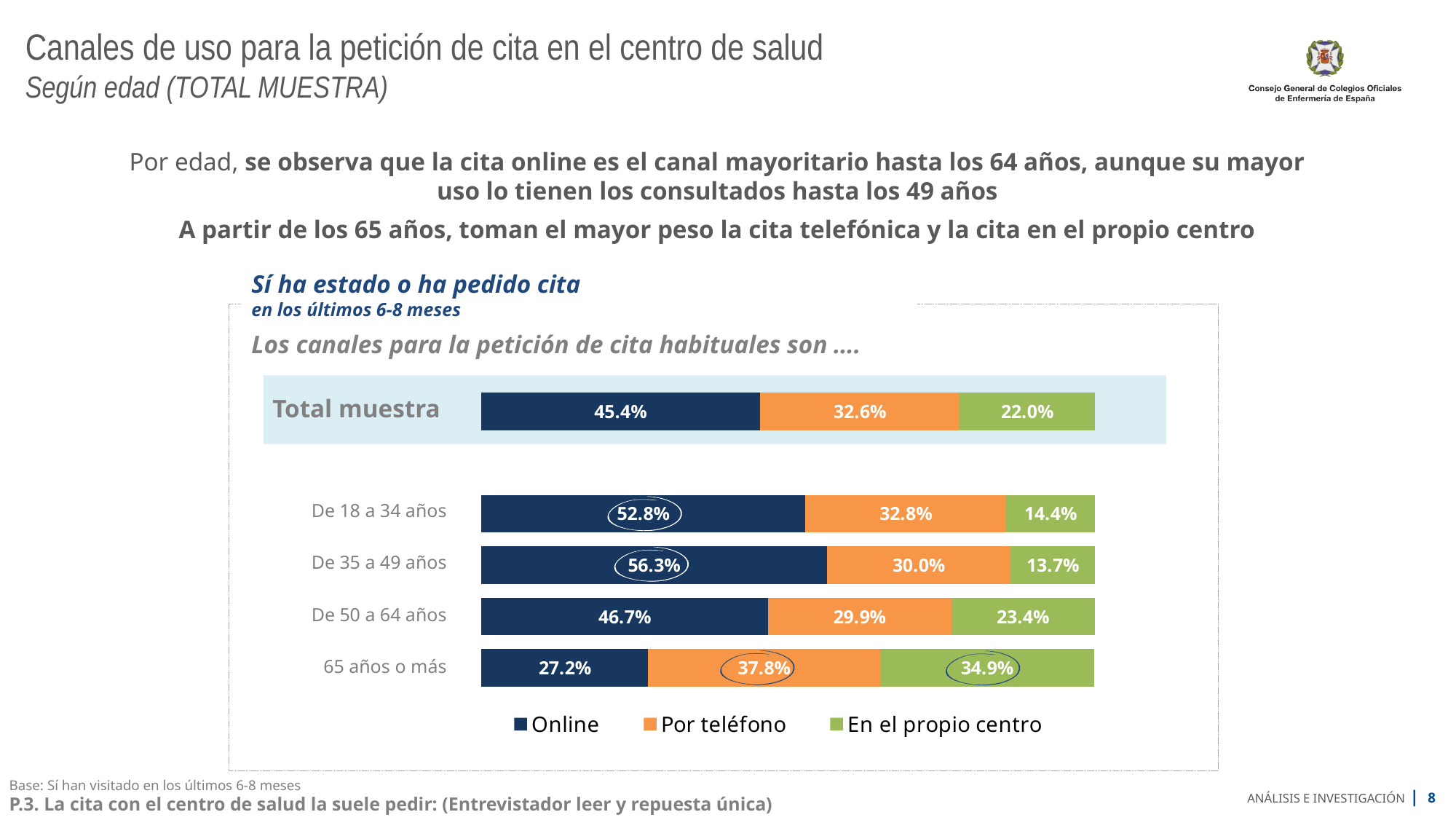
What is the 'Por teléfono' value for the '65 años o más' category? 37.8% Which is larger for 'De 50 a 64 años': the Online value or the 'Por teléfono' value? Online Which colour represents the 'Por teléfono' series in the legend? Orange How many age-group categories are plotted below the 'Total muestra' bar? 4 What kind of chart is shown on the slide? Stacked bar chart What is the 'En el propio centro' value for 'Total muestra'? 22.0% Which age group has the highest Online value? De 35 a 49 años Which age group has the lowest 'En el propio centro' value? De 35 a 49 años How many series does the legend list? 3 What is the difference between the Online values for 'De 18 a 34 años' and '65 años o más'? 25.6% What is the total of the 'De 50 a 64 años' stacked bar? 100.0% What is the Online value for the 'De 35 a 49 años' category? 56.3%